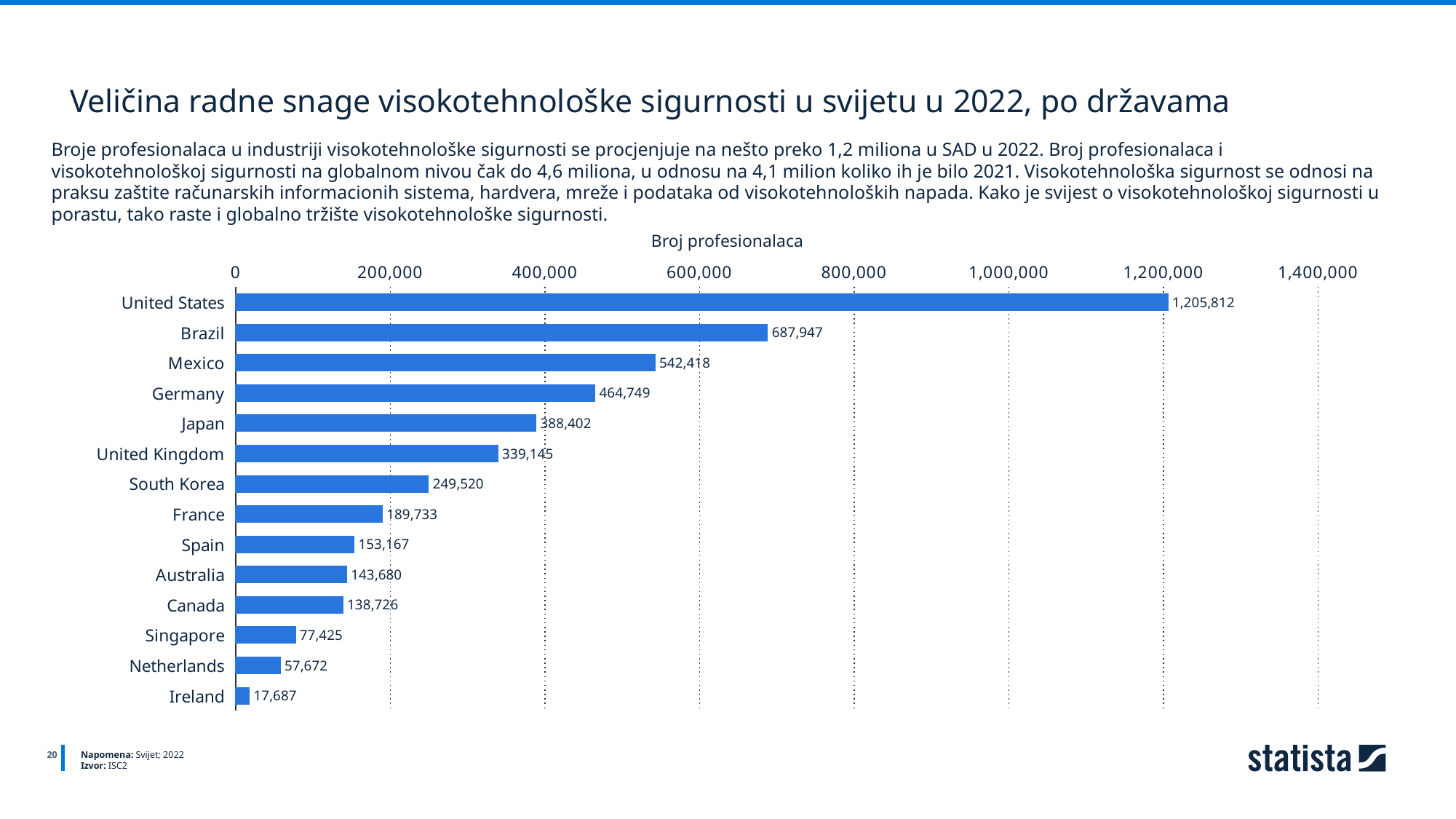
What is the difference between the values for Brazil and Mexico? 145,529 Which is larger, the value for France or the value for South Korea? South Korea How many countries are shown in the chart? 14 Which country has the lowest number of professionals? Ireland What is the label shown above the horizontal axis of the chart? Broj profesionalaca Which country has the highest number of professionals? United States What is the value for Japan? 388,402 What is the value for Singapore? 77,425 Is the value for United Kingdom greater or less than 400,000? less What is the difference between the values for Germany and Japan? 76,347 What is the value for Brazil? 687,947 What kind of chart is shown on the slide? bar chart